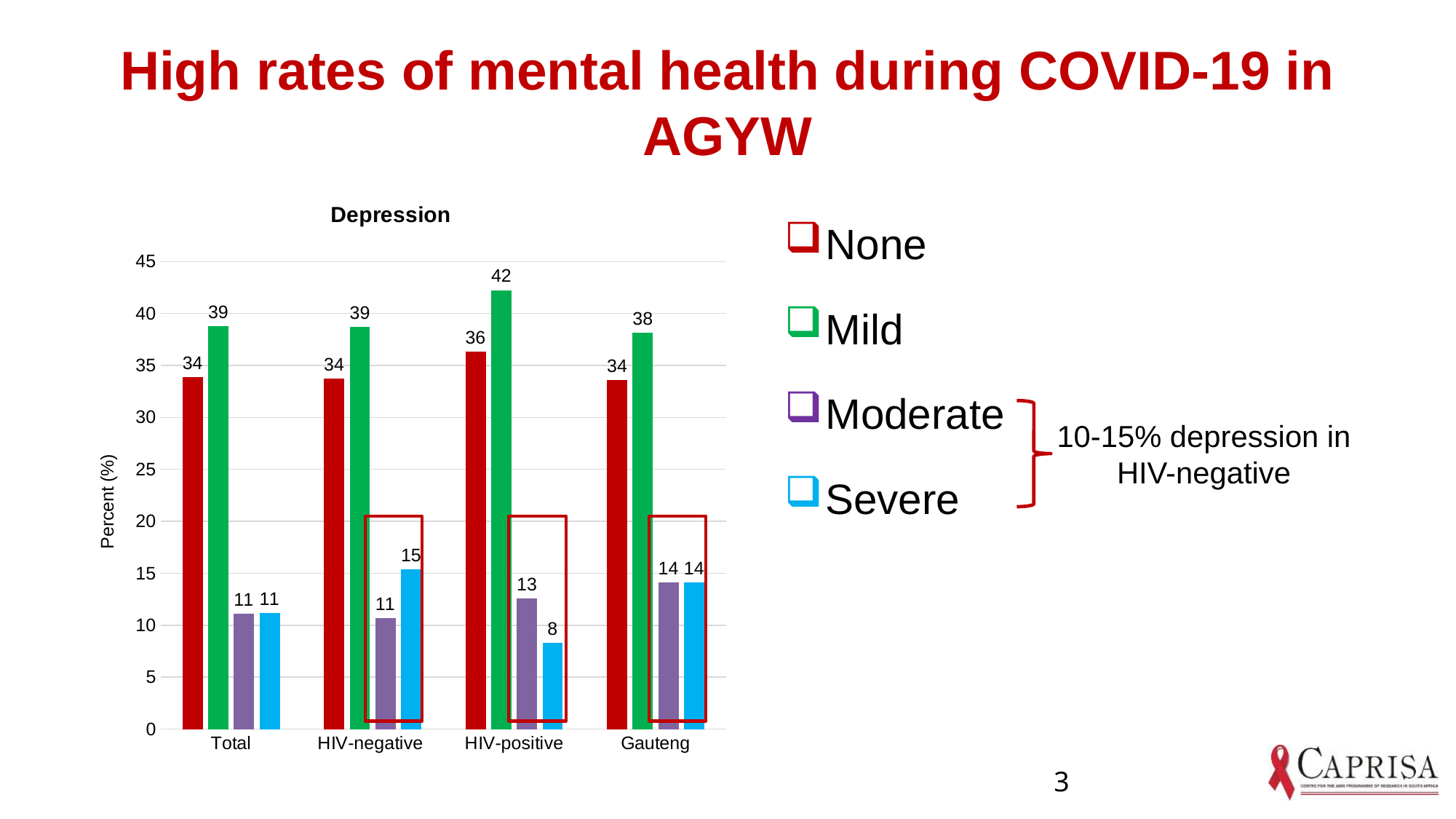
Which category has the highest Mild value? HIV-positive Which category has the lowest Severe value? HIV-positive Is the value for Severe in the HIV-positive category greater or less than 10? less What is the value for None in the Gauteng category? 34 How many categories are shown on the x axis? 4 What is the value for Mild in the HIV-positive category? 42 What kind of chart is shown? bar chart What is the title of the chart? Depression How many series does the legend list? 4 Which is larger in the HIV-negative category, Moderate or Severe? Severe What is the difference between the Mild and None values in the HIV-positive category? 6 What is the value for Severe in the HIV-negative category? 15